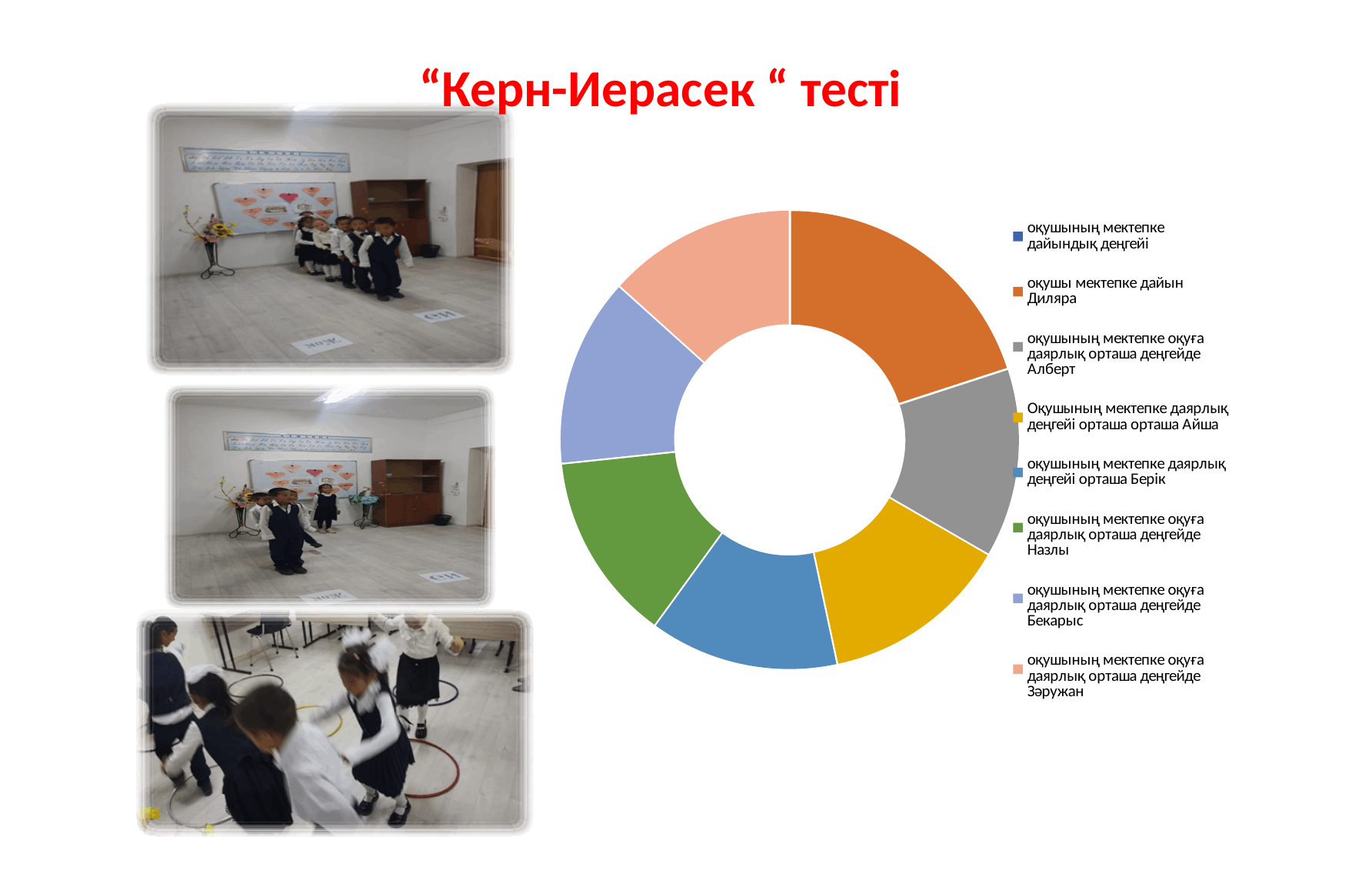
Which legend entry corresponds to the largest slice of the doughnut chart? оқушы мектепке дайын Диляра How many entries does the chart's legend list? 8 What is the title of the slide containing the chart? "Керн-Иерасек " тесті Which slice is larger: the one for Диляра or the one for Айша? Диляра Which slice is larger: the one for Диляра or the one for Алберт? Диляра What colour is the slice for "оқушы мектепке дайын Диляра"? orange What kind of chart is shown on the slide? doughnut (pie) chart